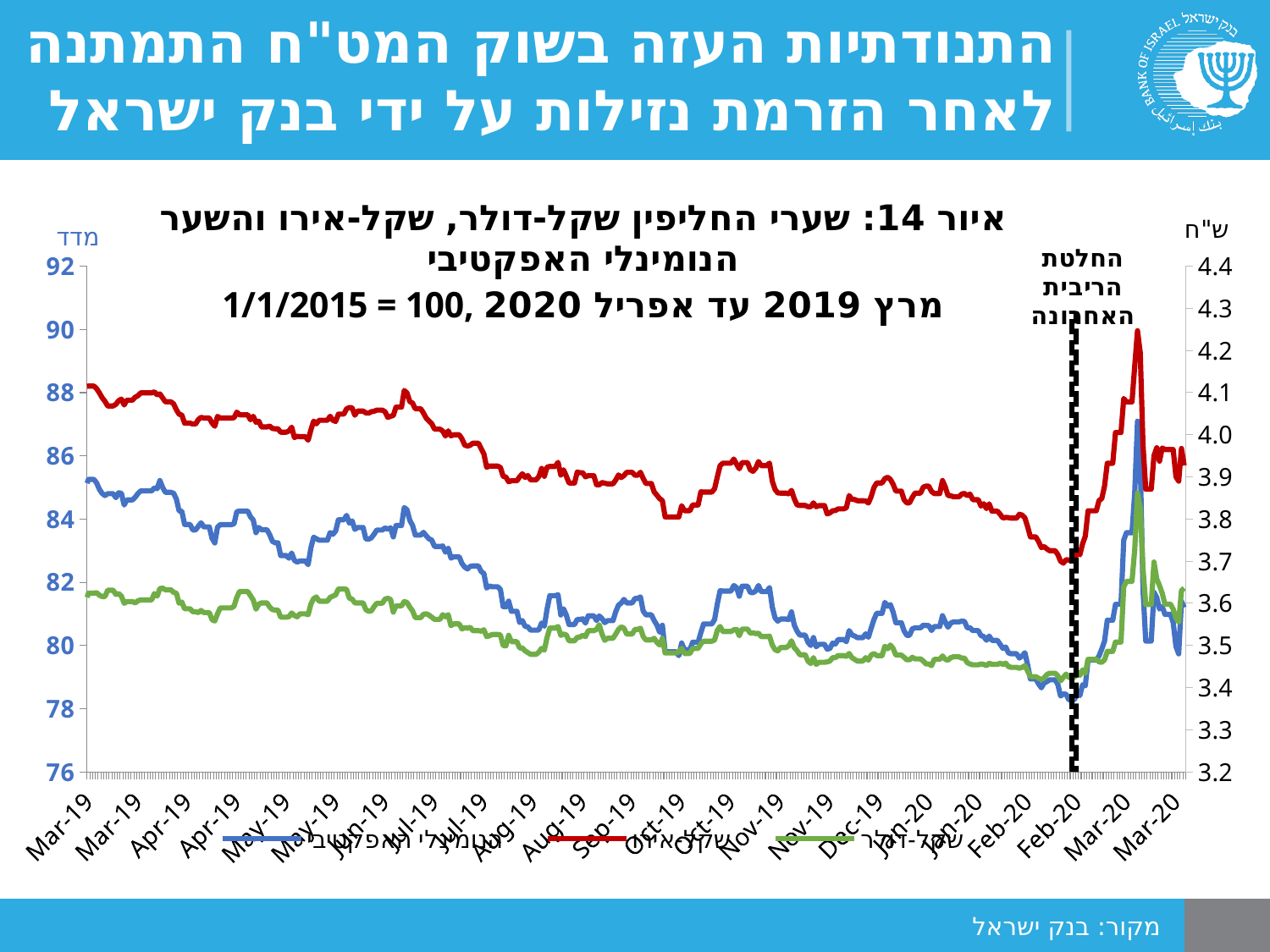
What event does the dashed vertical line on the chart mark? החלטת הריבית האחרונה Is the value of the blue line at the start of the chart (Mar-19) greater or less than 84 on the left axis? greater At the start of the chart (Mar-19), which is higher, the blue line or the green line? the blue line What kind of chart is shown on the slide? line chart How many series does the chart plot? 3 Does the red line generally rise or fall from Mar-19 to Feb-20? fall What is the range of the right-hand axis of the chart? 3.2 to 4.4 Which series is the highest line throughout the chart? the red line (שקל-אירו)